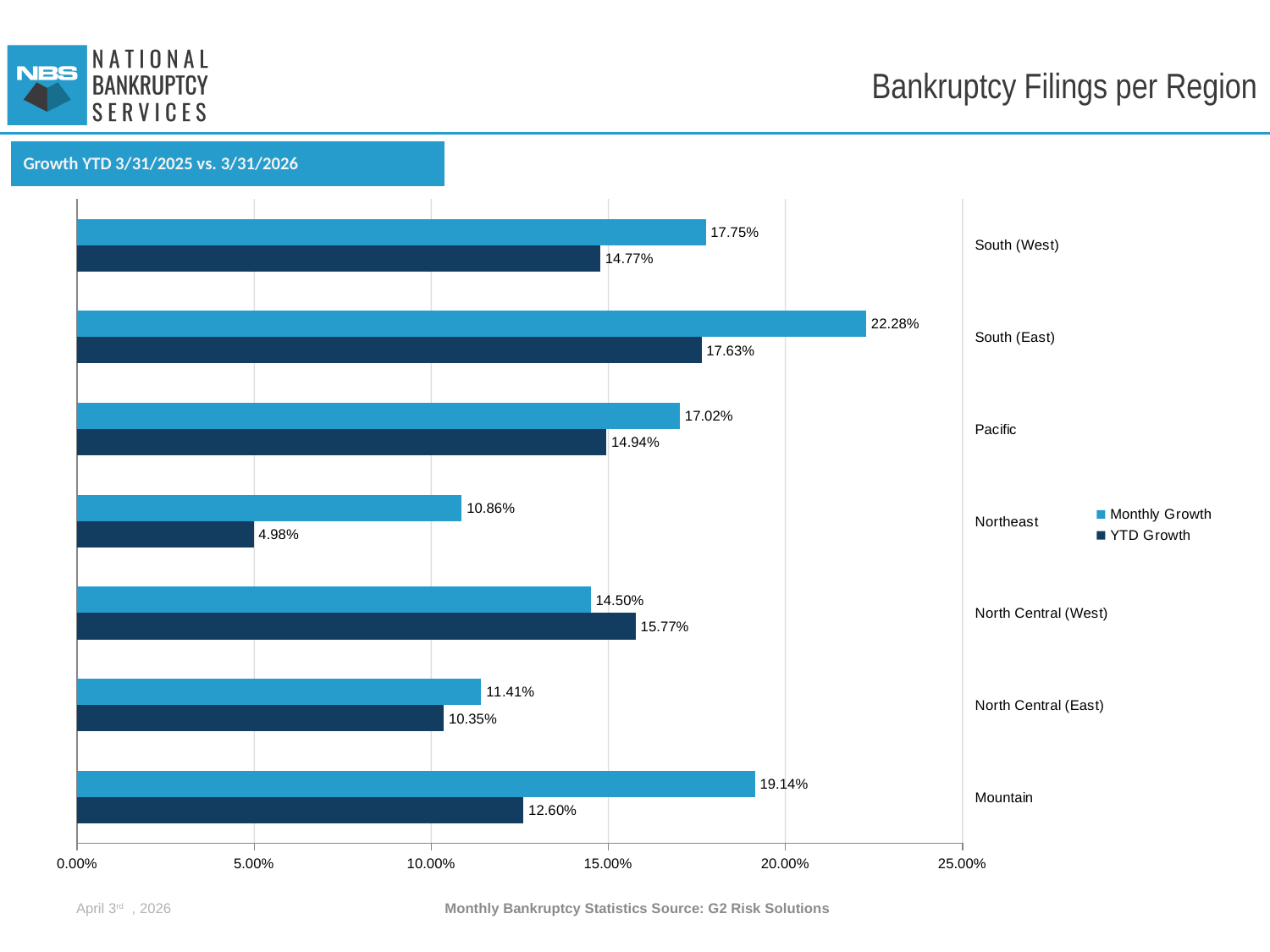
Which is larger for North Central (West): Monthly Growth or YTD Growth? YTD Growth How many series does the legend list? 2 How many regions are shown in the chart? 7 Which region has the highest Monthly Growth? South (East) What is the Monthly Growth value for South (East)? 22.28% What is the difference between Monthly Growth and YTD Growth for Mountain? 6.54% What is the title shown above the chart? Growth YTD 3/31/2025 vs. 3/31/2026 What kind of chart is shown on the slide? Bar chart What is the YTD Growth value for Northeast? 4.98% Is the Monthly Growth value for Pacific greater or less than 15.00%? greater Which region has the lowest YTD Growth? Northeast What is the YTD Growth value for Mountain? 12.60%